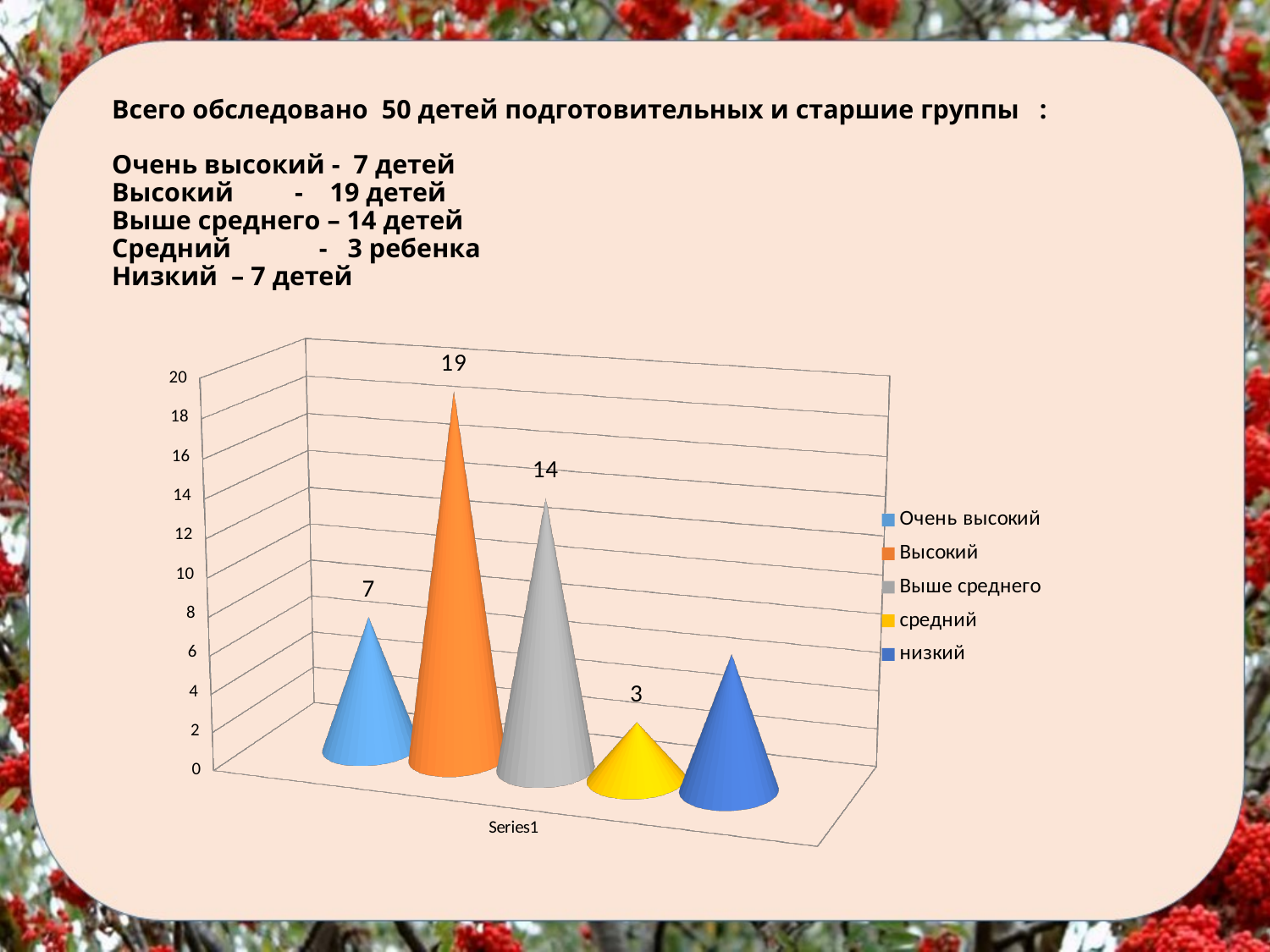
Which is larger, the value for Очень высокий or the value for Выше среднего? Выше среднего Which category has the highest value? Высокий What colour is the bar for Высокий? orange What kind of chart is shown on the slide? bar chart What is the difference between the values for Высокий and Выше среднего? 5 What is the value for Очень высокий? 7 How many categories are plotted in the chart? 5 What is the value for средний? 3 What is the value for Высокий? 19 What is the value for Выше среднего? 14 Which category has the lowest value? средний Is the value for низкий greater or less than 10? less